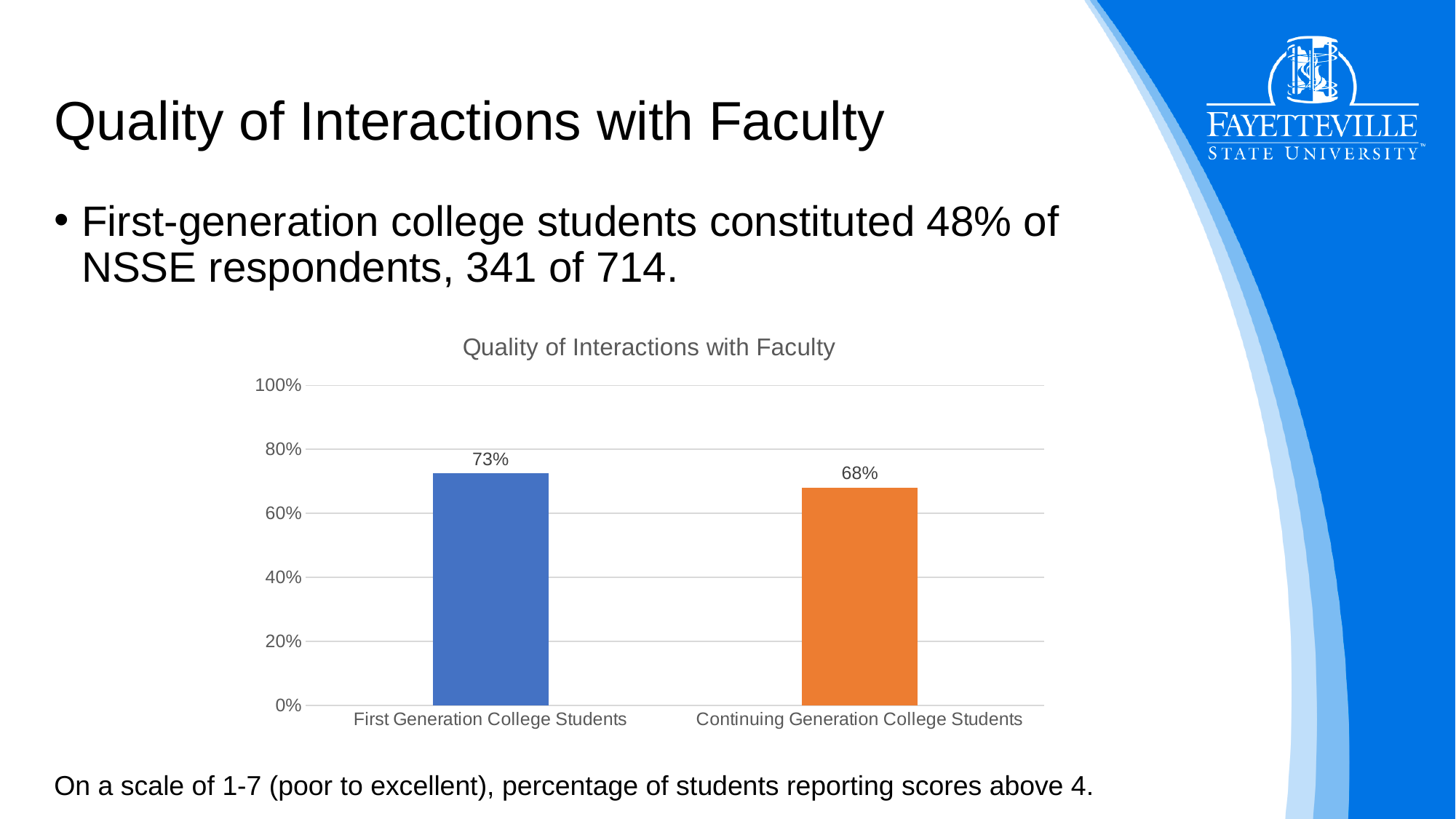
What is the value for First Generation College Students? 73% Which is larger, the value for First Generation College Students or for Continuing Generation College Students? First Generation College Students Which category has the highest value? First Generation College Students Is the value for Continuing Generation College Students greater or less than 80%? less What is the difference between the values for First Generation College Students and Continuing Generation College Students? 5% What colour is the bar for Continuing Generation College Students? Orange How many categories are shown in the chart? 2 Is the value for First Generation College Students greater or less than 60%? greater What kind of chart is shown on the slide? Bar chart Which category has the lowest value? Continuing Generation College Students What is the value for Continuing Generation College Students? 68% What is the title of the chart? Quality of Interactions with Faculty